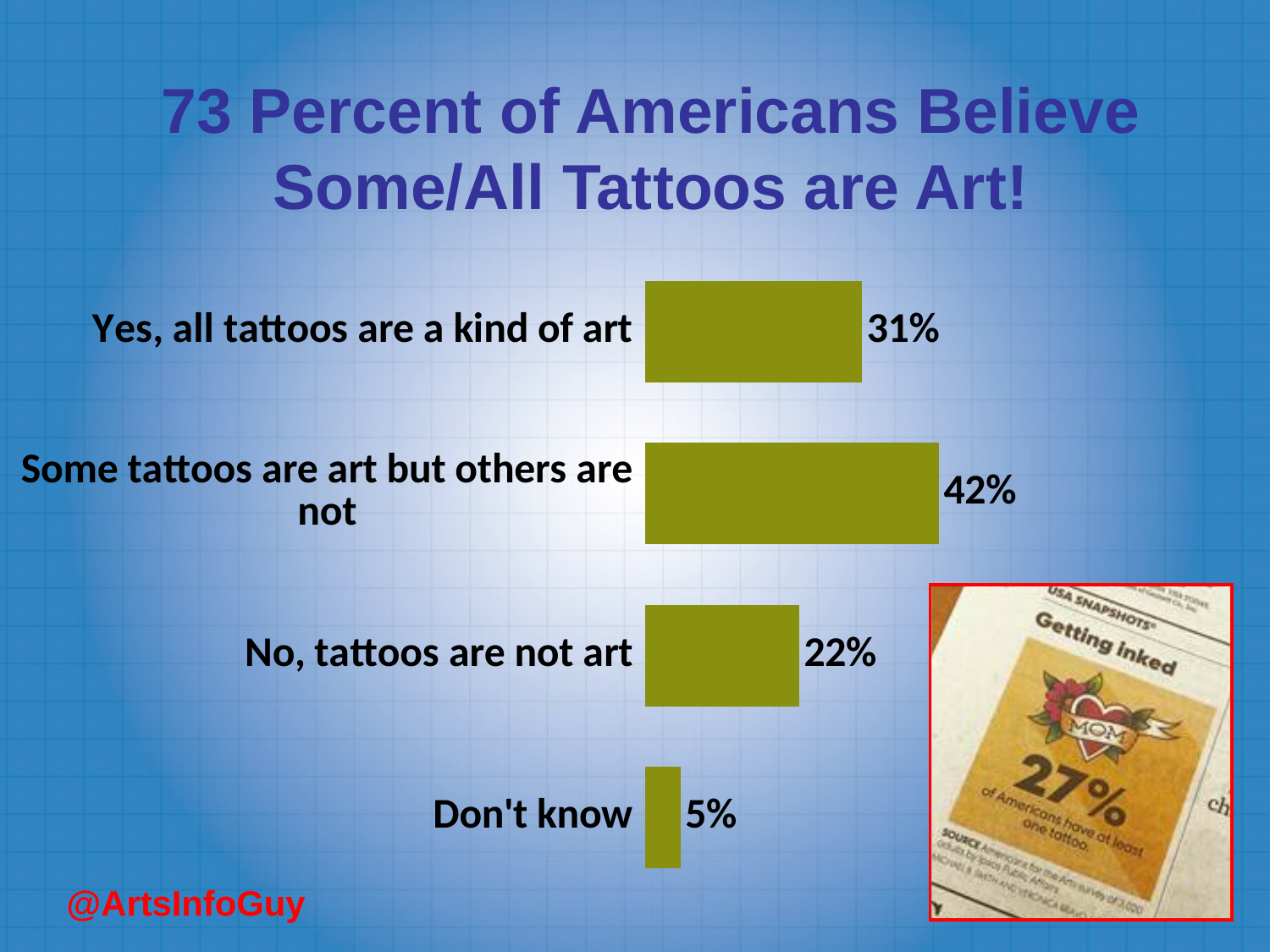
Which response category has the lowest percentage? Don't know What is the difference in percentage points between 'Some tattoos are art but others are not' and 'Yes, all tattoos are a kind of art'? 11 What is the title of the slide containing the chart? 73 Percent of Americans Believe Some/All Tattoos are Art! What percentage of respondents said 'Yes, all tattoos are a kind of art'? 31% What percentage of respondents said 'Some tattoos are art but others are not'? 42% Which is larger: the percentage for 'Yes, all tattoos are a kind of art' or for 'No, tattoos are not art'? Yes, all tattoos are a kind of art What percentage of respondents said 'No, tattoos are not art'? 22% What percentage of respondents answered 'Don't know'? 5% How many response categories are shown in the chart? 4 Which response category has the highest percentage? Some tattoos are art but others are not What kind of chart is shown on the slide? Bar chart What is the difference in percentage points between 'No, tattoos are not art' and 'Don't know'? 17